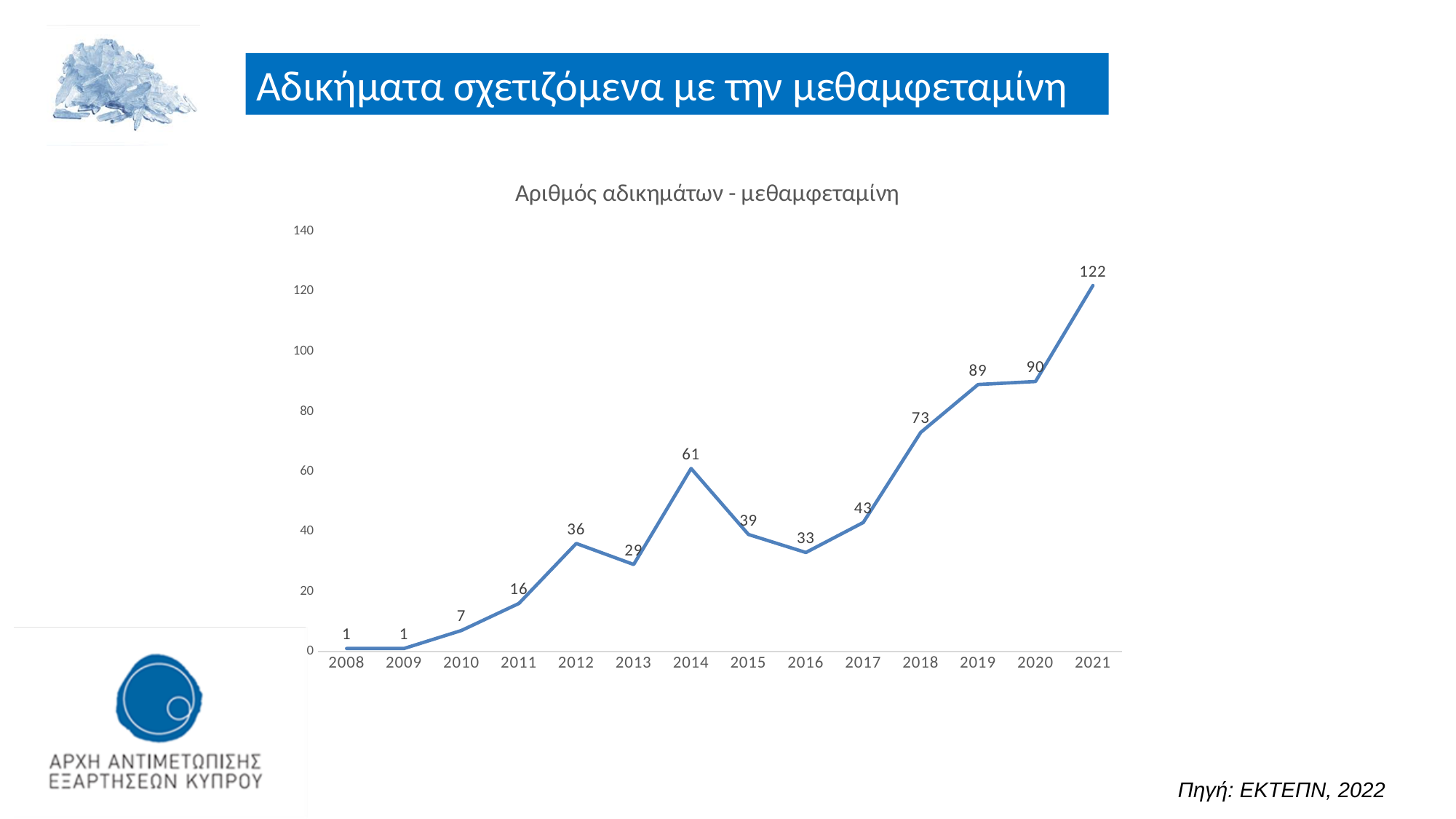
How many years are plotted on the x axis? 14 What is the number of methamphetamine-related offences in 2014? 61 What kind of chart is shown on the slide? Line chart Which year has the highest number of offences? 2021 Do the values generally rise or fall from 2016 to 2021? Rise What is the title of the chart? Αριθμός αδικημάτων - μεθαμφεταμίνη Which is larger, the value for 2012 or the value for 2015? 2015 What is the difference between the values for 2014 and 2013? 32 Is the value for 2018 greater or less than 60? greater What is the difference between the values for 2021 and 2020? 32 What is the value shown for 2021? 122 What is the value shown for 2016? 33